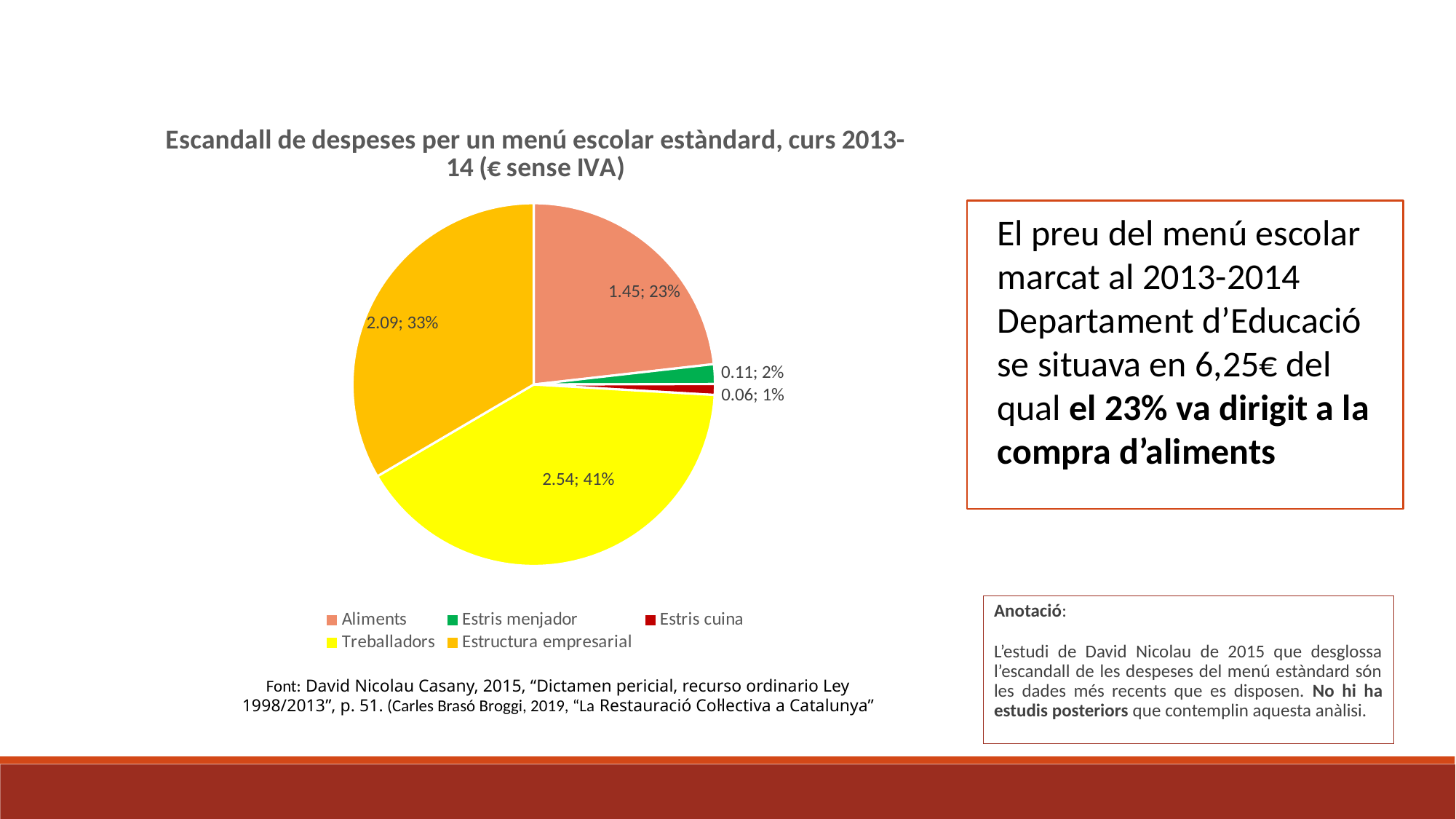
What share of the pie does Estructura empresarial represent? 33% What is the value for Aliments in the pie chart? 1.45 How many categories does the pie chart legend list? 5 Which category has the smallest slice of the pie chart? Estris cuina What share of the pie does Estris menjador represent? 2% What is the value for Treballadors in the pie chart? 2.54 What is the value for Estris cuina in the pie chart? 0.06 What kind of chart is shown on the slide? Pie chart What is the value for Estructura empresarial in the pie chart? 2.09 Which is larger, the value for Aliments or the value for Estructura empresarial? Estructura empresarial What is the difference between the values for Treballadors and Aliments? 1.09 Which category has the largest slice of the pie chart? Treballadors